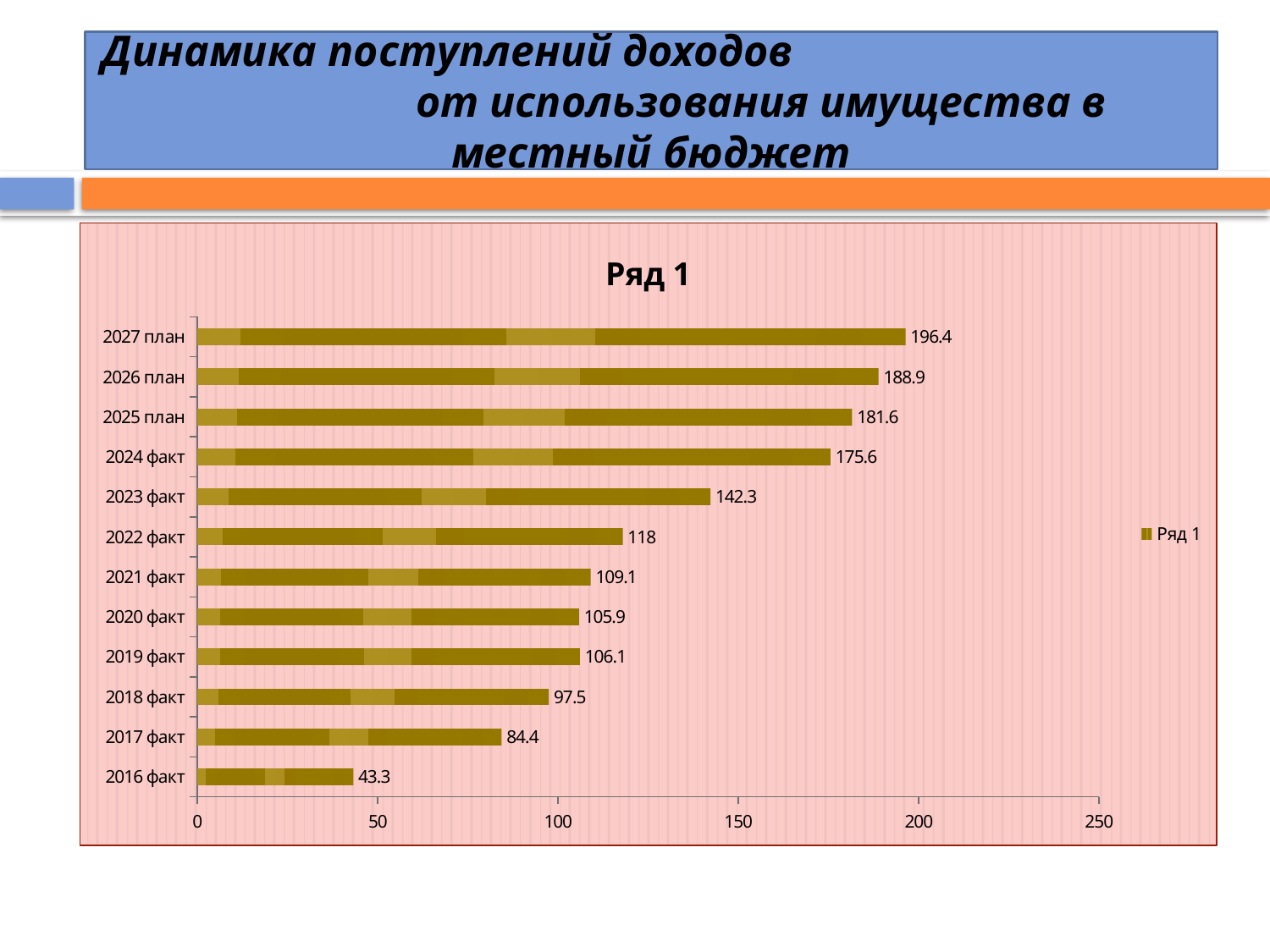
What kind of chart is shown on the slide? Bar chart What is the value for 2016 факт? 43.3 How many series does the legend list? 1 What is the difference between the values for 2027 план and 2026 план? 7.5 Which category has the lowest value? 2016 факт Which is larger, the value for 2018 факт or the value for 2017 факт? 2018 факт What is the value for 2022 факт? 118 Which category has the highest value? 2027 план How many categories are shown on the chart? 12 What is the name of the series shown in the legend? Ряд 1 What is the value for 2024 факт? 175.6 What is the difference between the values for 2023 факт and 2022 факт? 24.3